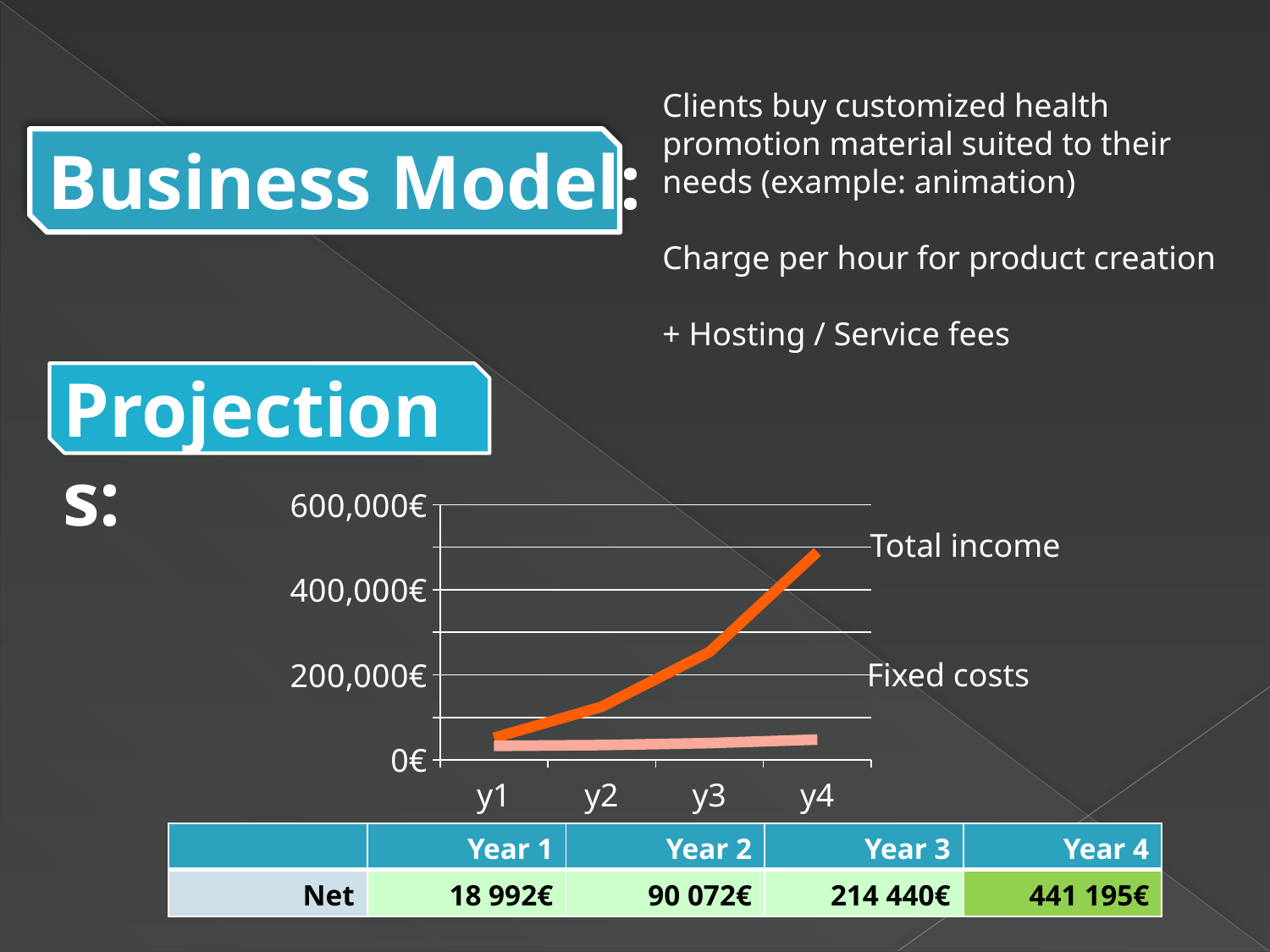
What kind of chart is shown on the slide? line chart How many series are plotted on the chart? 2 At which year is Total income lowest? y1 At which year is Total income highest? y4 Is the value for Fixed costs at y4 greater or less than 200,000€? less Is the value for Total income at y1 greater or less than 200,000€? less Is the value for Total income at y4 greater or less than 400,000€? greater At y4, which is larger: Total income or Fixed costs? Total income How many points are plotted along the x axis for each series? 4 Which series is labelled at the top of the chart, next to the upper line? Total income Does Total income rise or fall from y1 to y4? rise